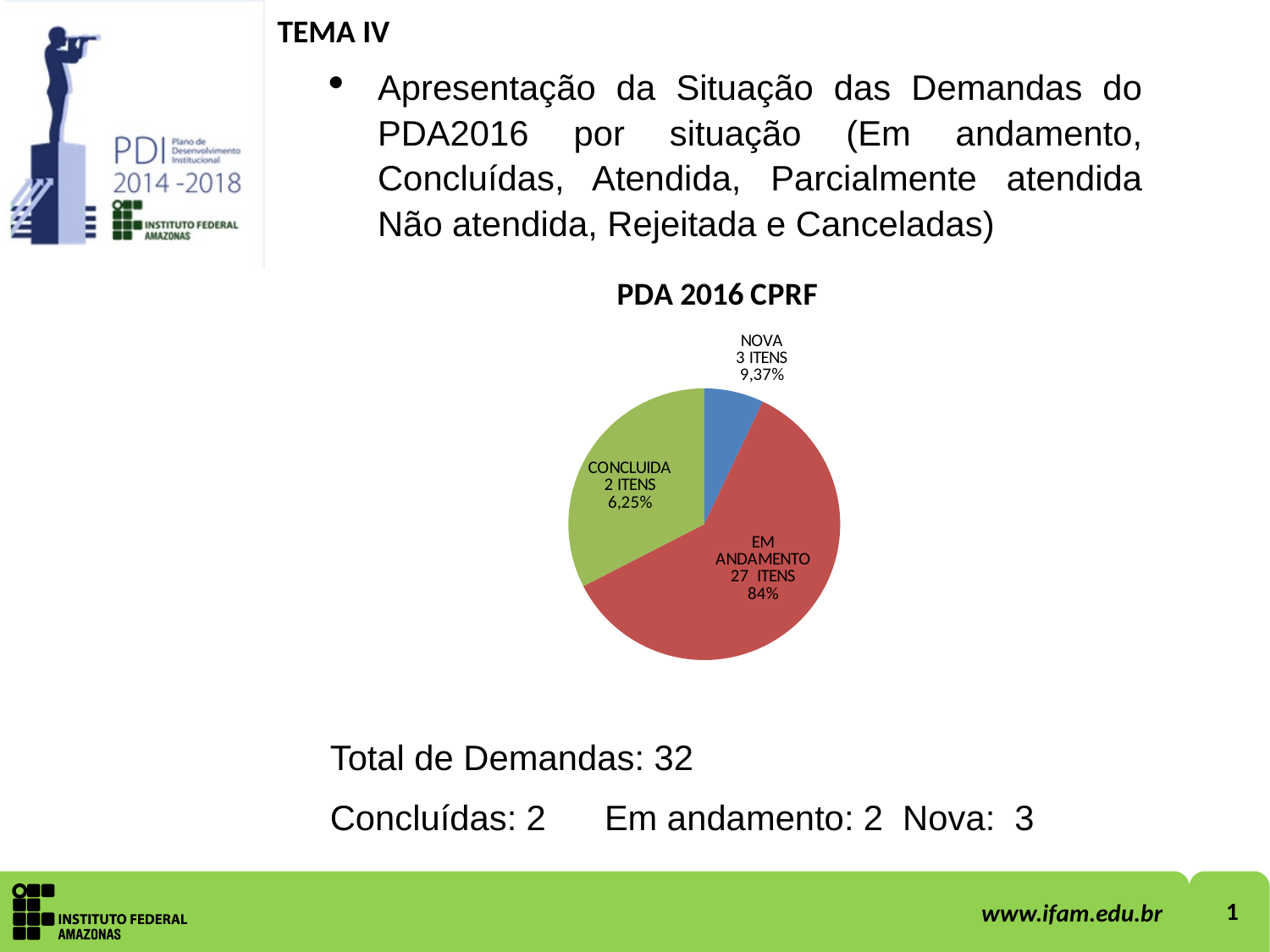
How many items are in the EM ANDAMENTO slice? 27 ITENS What is the title of the chart? PDA 2016 CPRF What type of chart is shown on the slide? pie chart Which category has the largest slice of the pie? EM ANDAMENTO How many items are in the CONCLUIDA slice? 2 ITENS How many more items does EM ANDAMENTO have than NOVA? 24 What percentage is printed for the CONCLUIDA slice? 6,25% Which has more items, EM ANDAMENTO or NOVA? EM ANDAMENTO What share of the pie does EM ANDAMENTO represent? 84% What share of the pie does NOVA represent? 9,37% How many slices does the pie chart have? 3 How many items are in the NOVA slice? 3 ITENS